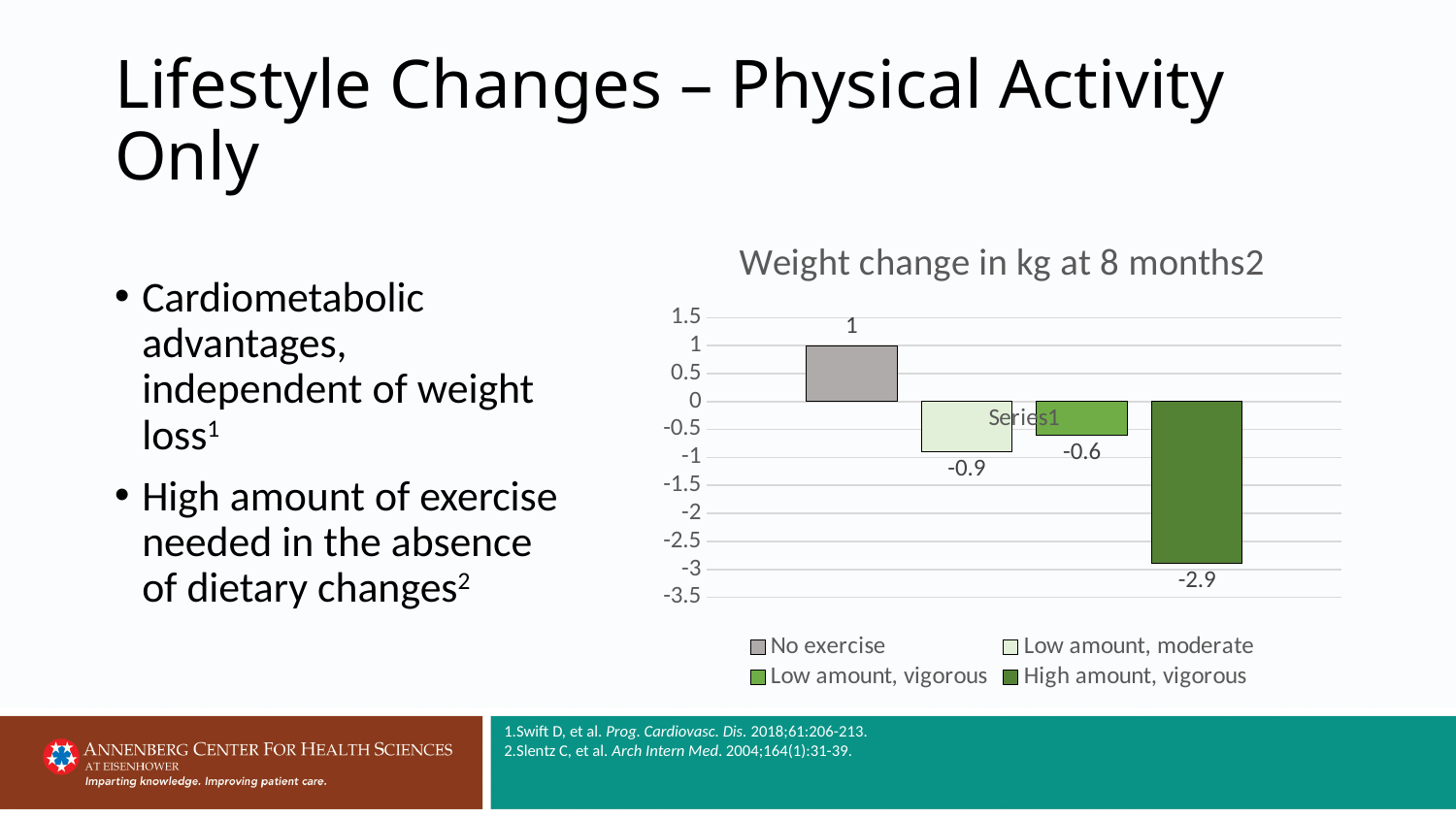
What is the weight change in kg for the No exercise group? 1 Which group has the highest value on the chart? No exercise What is the difference between the weight change for High amount, vigorous and Low amount, vigorous? 2.3 What is the weight change in kg for the High amount, vigorous group? -2.9 How many series does the legend list? 4 What is the weight change in kg for the Low amount, vigorous group? -0.6 What kind of chart is shown on the slide? Bar chart Which group shows the largest weight loss (lowest value)? High amount, vigorous What is the title of the chart? Weight change in kg at 8 months2 What is the weight change in kg for the Low amount, moderate group? -0.9 Which has a larger weight loss: Low amount, moderate or Low amount, vigorous? Low amount, moderate Which legend entry is shown in dark green? High amount, vigorous